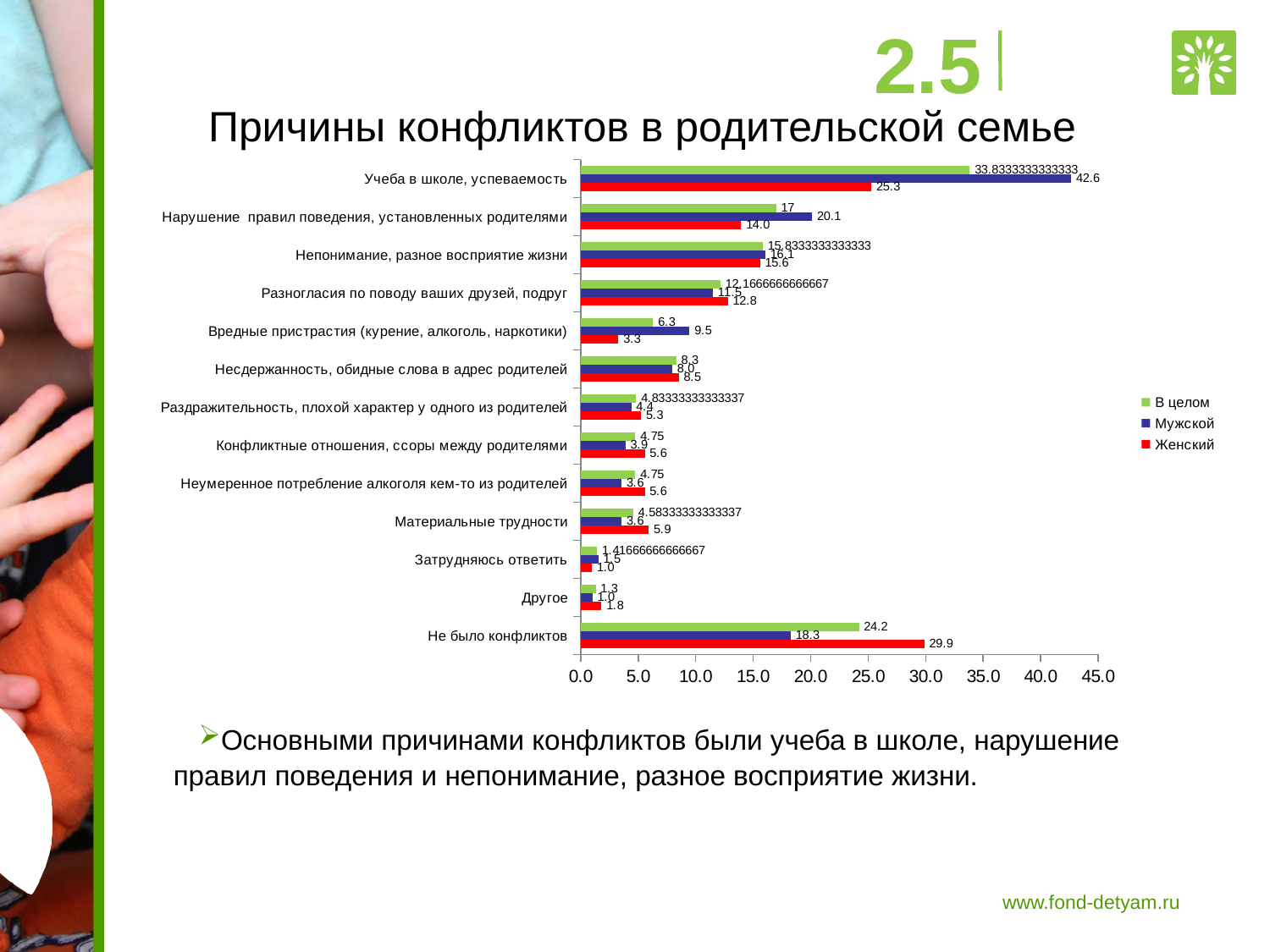
What is the value for Мужской in the category 'Нарушение правил поведения, установленных родителями'? 20.1 What is the difference between the Мужской and Женский values for 'Учеба в школе, успеваемость'? 17.3 What is the value for Мужской in the category 'Учеба в школе, успеваемость'? 42.6 Which category has the lowest value for the Женский series? Затрудняюсь ответить What is the title of the chart? Причины конфликтов в родительской семье What type of chart is shown on the slide? bar chart How many categories are shown on the chart? 13 Which category has the highest value for the Мужской series? Учеба в школе, успеваемость For 'Не было конфликтов', which is larger: the Мужской value or the Женский value? Женский What is the value for Женский in the category 'Вредные пристрастия (курение, алкоголь, наркотики)'? 3.3 How many series does the legend list? 3 What is the value for Женский in the category 'Не было конфликтов'? 29.9